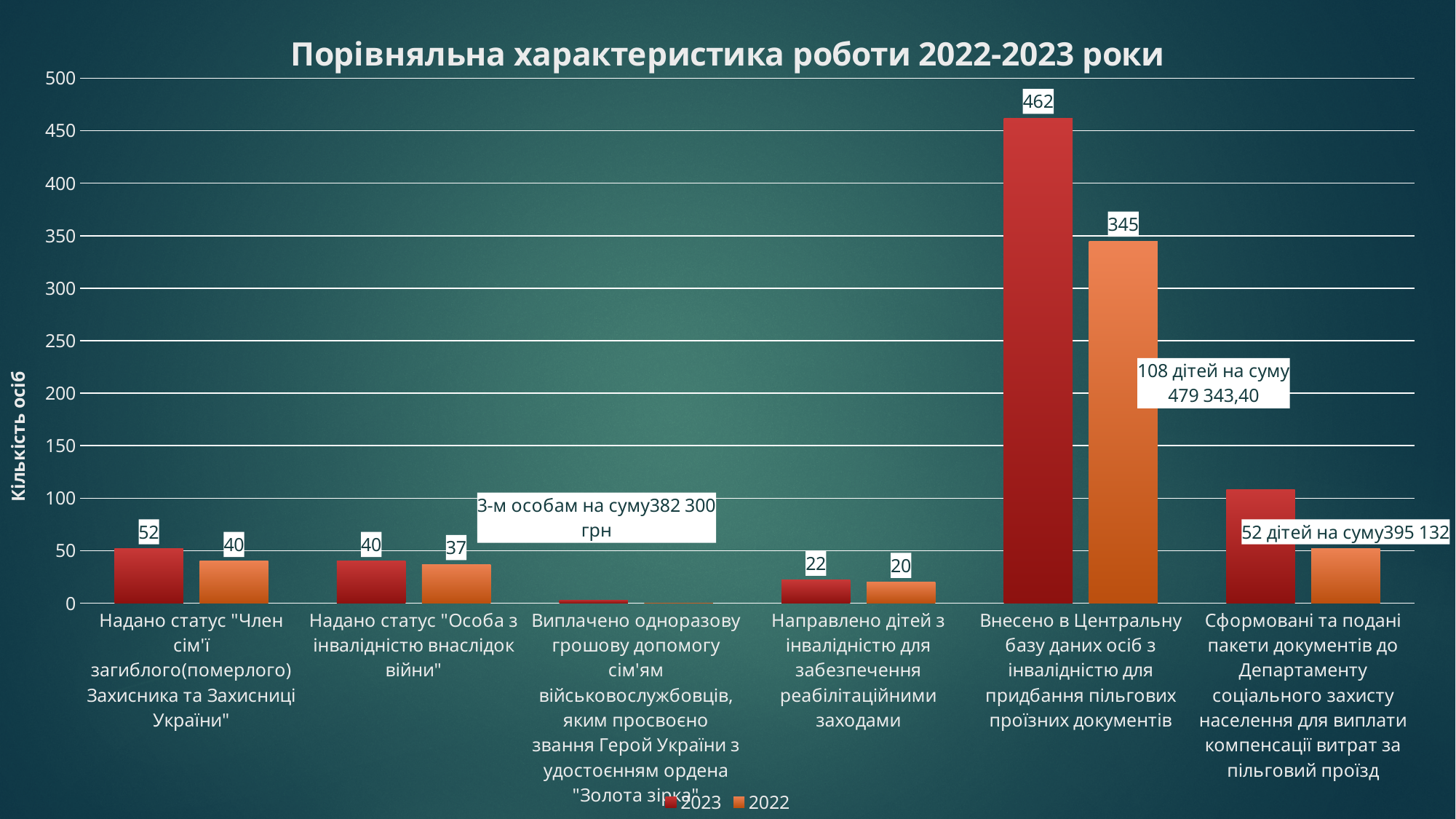
Which category has the highest 2023 value? Внесено в Центральну базу даних осіб з інвалідністю для придбання пільгових проїзних документів What is the 2023 value for "Внесено в Центральну базу даних осіб з інвалідністю для придбання пільгових проїзних документів"? 462 Is the 2023 value for "Сформовані та подані пакети документів до Департаменту соціального захисту населення для виплати компенсації витрат за пільговий проїзд" greater or less than 100? greater What is the 2022 value for "Направлено дітей з інвалідністю для забезпечення реабілітаційними заходами"? 20 What is the 2022 value for "Внесено в Центральну базу даних осіб з інвалідністю для придбання пільгових проїзних документів"? 345 What is the title of the chart? Порівняльна характеристика роботи 2022-2023 роки For "Надано статус "Особа з інвалідністю внаслідок війни"", which is larger: the 2023 value or the 2022 value? 2023 How many categories are shown on the x axis? 6 What type of chart is shown on the slide? bar chart What is the 2023 value for "Надано статус "Член сім'ї загиблого(померлого) Захисника та Захисниці України""? 52 How many series does the legend list? 2 What is the difference between the 2023 and 2022 values for "Внесено в Центральну базу даних осіб з інвалідністю для придбання пільгових проїзних документів"? 117